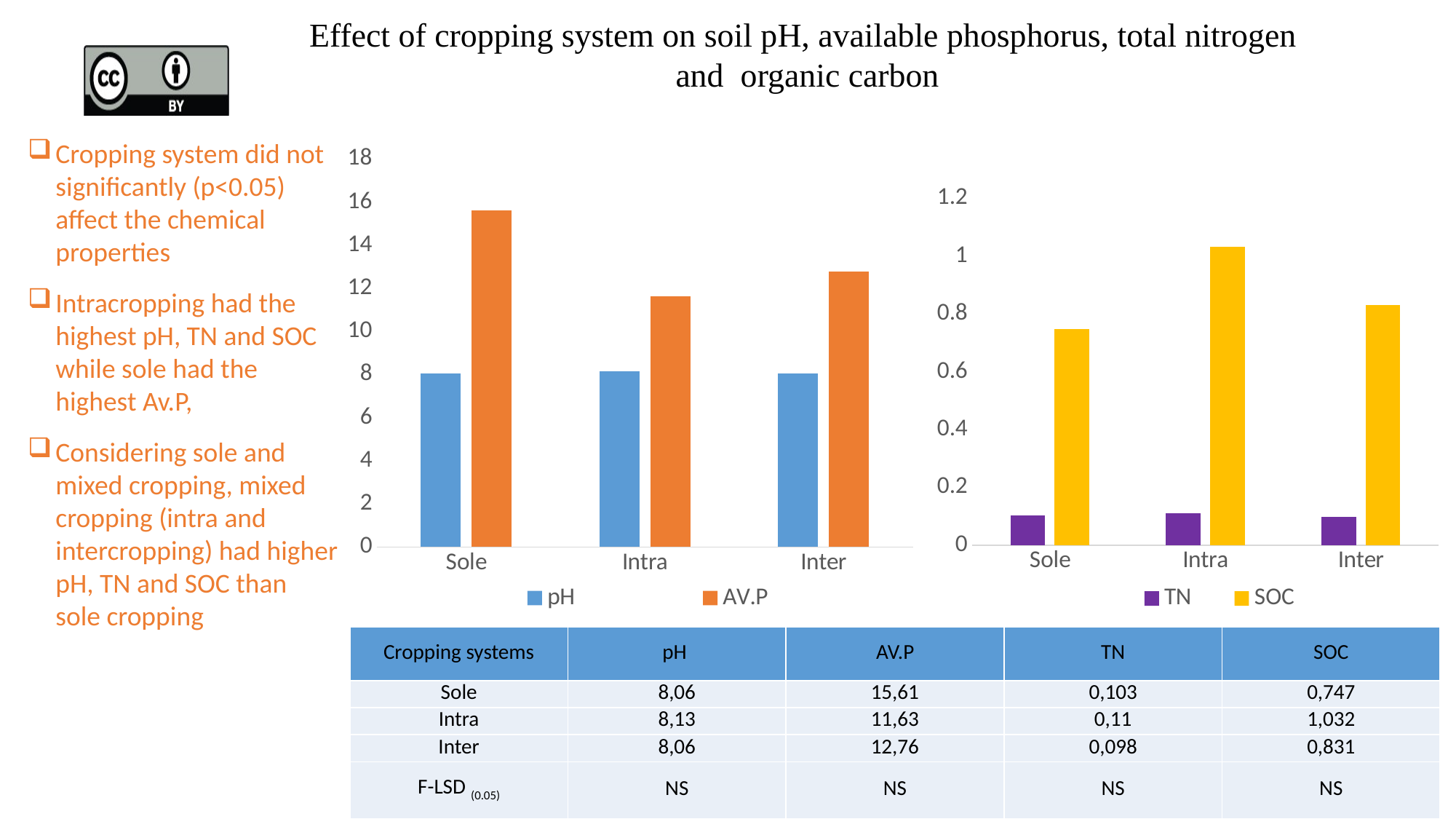
How many categories are shown on the x axis of the left chart? 3 In the right chart, which category has the lowest SOC value? Sole How many series does the legend of the right chart list? 2 In the right chart, is the SOC value for Intra greater or less than 1? greater In the right chart, is the SOC value for Inter larger than the SOC value for Sole? Yes In the left chart, which category has the highest AV.P value? Sole What kind of chart is the left chart? Bar chart In the left chart, is the AV.P value for Inter larger than the AV.P value for Intra? Yes In the left chart, which category has the lowest AV.P value? Intra In the left chart, is the AV.P value for Sole greater or less than 14? greater In the right chart, which category has the highest SOC value? Intra What are the two series listed in the legend of the left chart? pH and AV.P